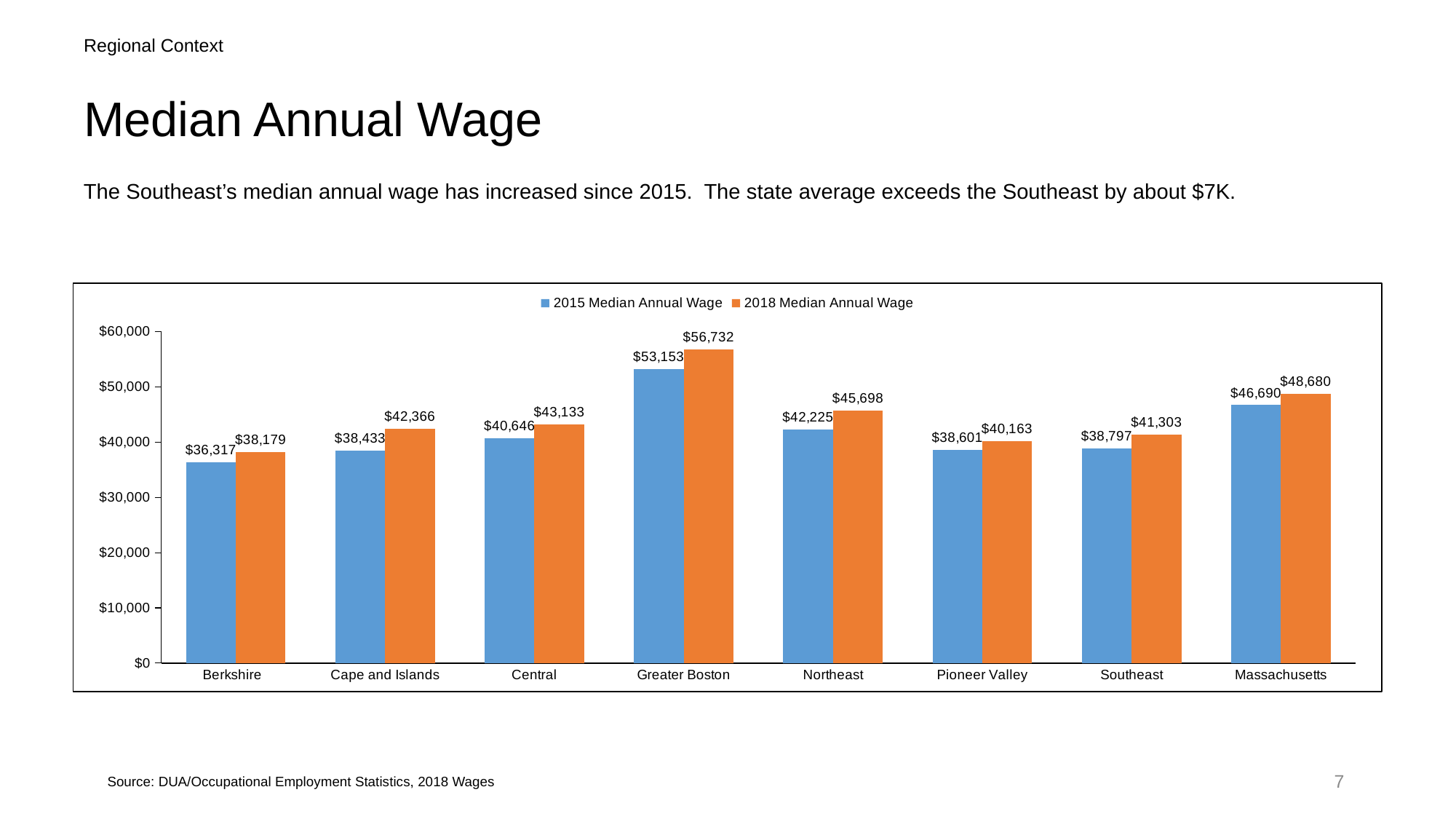
Which region has the lowest 2015 Median Annual Wage? Berkshire What is the difference between the Southeast's 2018 and 2015 Median Annual Wage? $2,506 How many series does the legend list? 2 Which region has the highest 2018 Median Annual Wage? Greater Boston What kind of chart is shown on the slide? Bar chart Which series is shown in orange in the legend? 2018 Median Annual Wage What is the 2018 Median Annual Wage for Massachusetts? $48,680 By how much does the 2018 Median Annual Wage for Massachusetts exceed that of the Southeast? $7,377 What is the 2015 Median Annual Wage for Greater Boston? $53,153 Which is larger, the 2015 Median Annual Wage for Central or for Northeast? Northeast What is the 2018 Median Annual Wage for the Southeast? $41,303 How many regions are shown on the x axis? 8